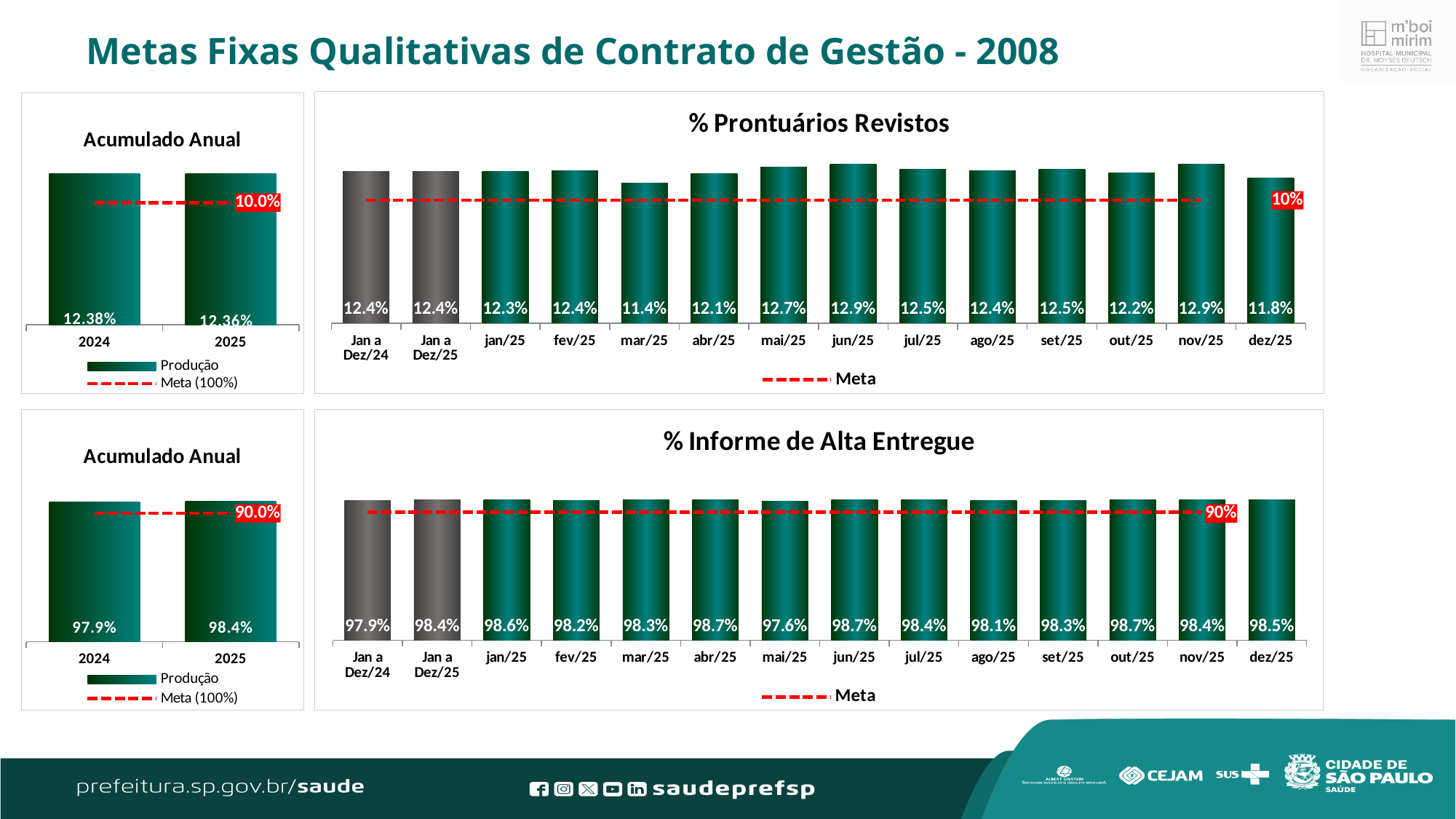
In the bottom-left 'Acumulado Anual' chart, which year has the higher value, 2024 or 2025? 2025 In the '% Prontuários Revistos' chart, what is the value for mar/25? 11.4% In the top-left 'Acumulado Anual' chart, what is the value for 2024? 12.38% In the '% Informe de Alta Entregue' chart, what is the value for Jan a Dez/25? 98.4% What type of chart is the '% Informe de Alta Entregue' chart? Bar chart In the '% Informe de Alta Entregue' chart, which month of 2025 has the lowest value? mai/25 In the '% Prontuários Revistos' chart, which month of 2025 has the lowest value? mar/25 In the '% Prontuários Revistos' chart, what is the difference between the values for jun/25 and mar/25? 1.5% In the '% Informe de Alta Entregue' chart, what is the value for abr/25? 98.7% In the '% Informe de Alta Entregue' chart, what is the Meta value shown on the dashed line label? 90% In the bottom-left 'Acumulado Anual' chart, what is the difference between the 2025 and 2024 values? 0.5% How many bars are plotted in the '% Prontuários Revistos' chart? 14